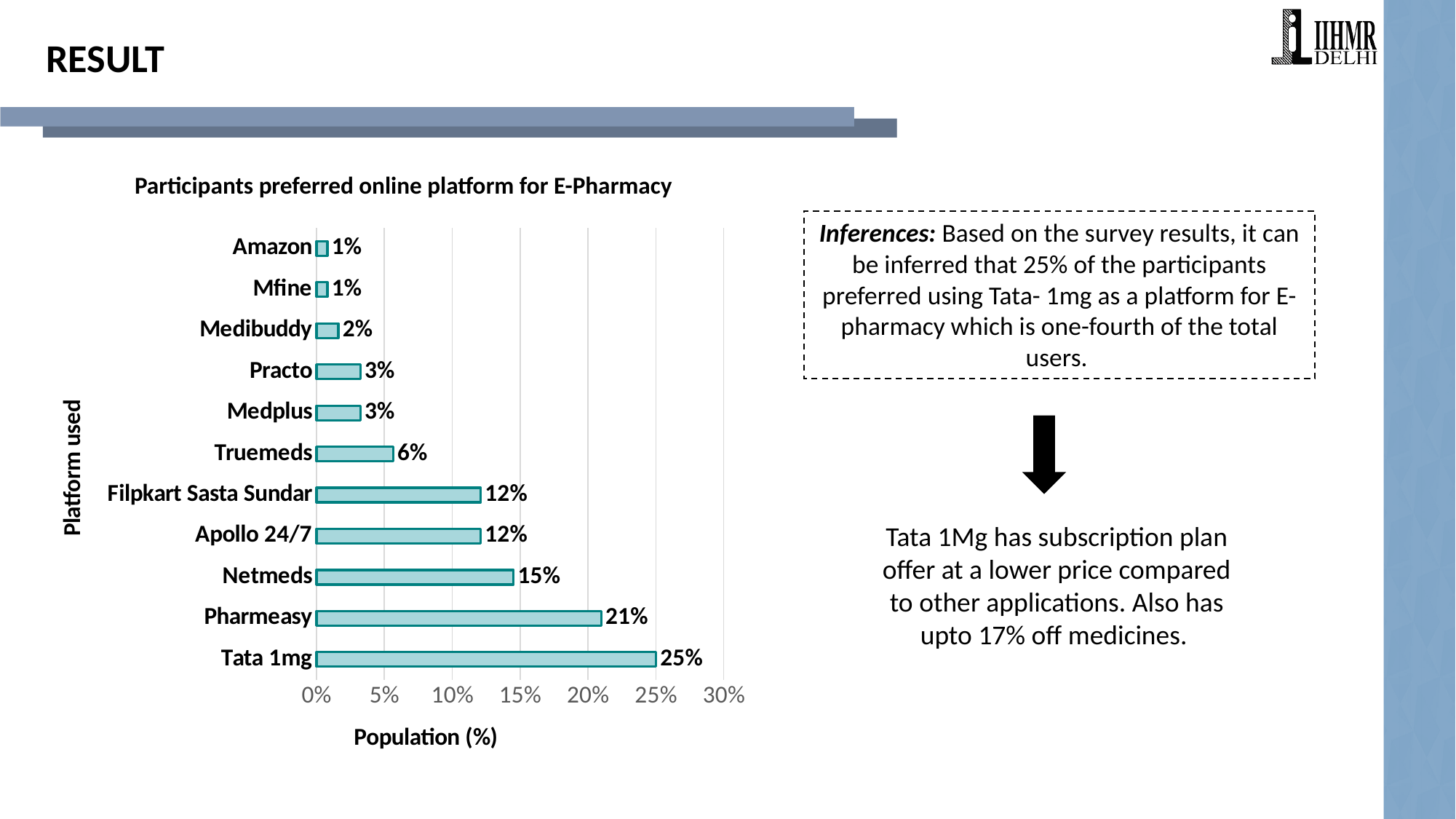
Which is larger, the value for Truemeds or the value for Medibuddy? Truemeds What is the value shown for Netmeds? 15% Which platform has the highest value in the chart? Tata 1mg What is the title of the chart? Participants preferred online platform for E-Pharmacy What is the difference between the values for Tata 1mg and Pharmeasy? 4% What kind of chart is shown on the slide? Bar chart Is the value for Pharmeasy greater or less than 20%? greater What is the difference between the values for Netmeds and Apollo 24/7? 3% What is the value shown for Truemeds? 6% How many platforms are shown in the chart? 11 What percentage of participants preferred Tata 1mg? 25% Which is larger, the value for Pharmeasy or the value for Netmeds? Pharmeasy